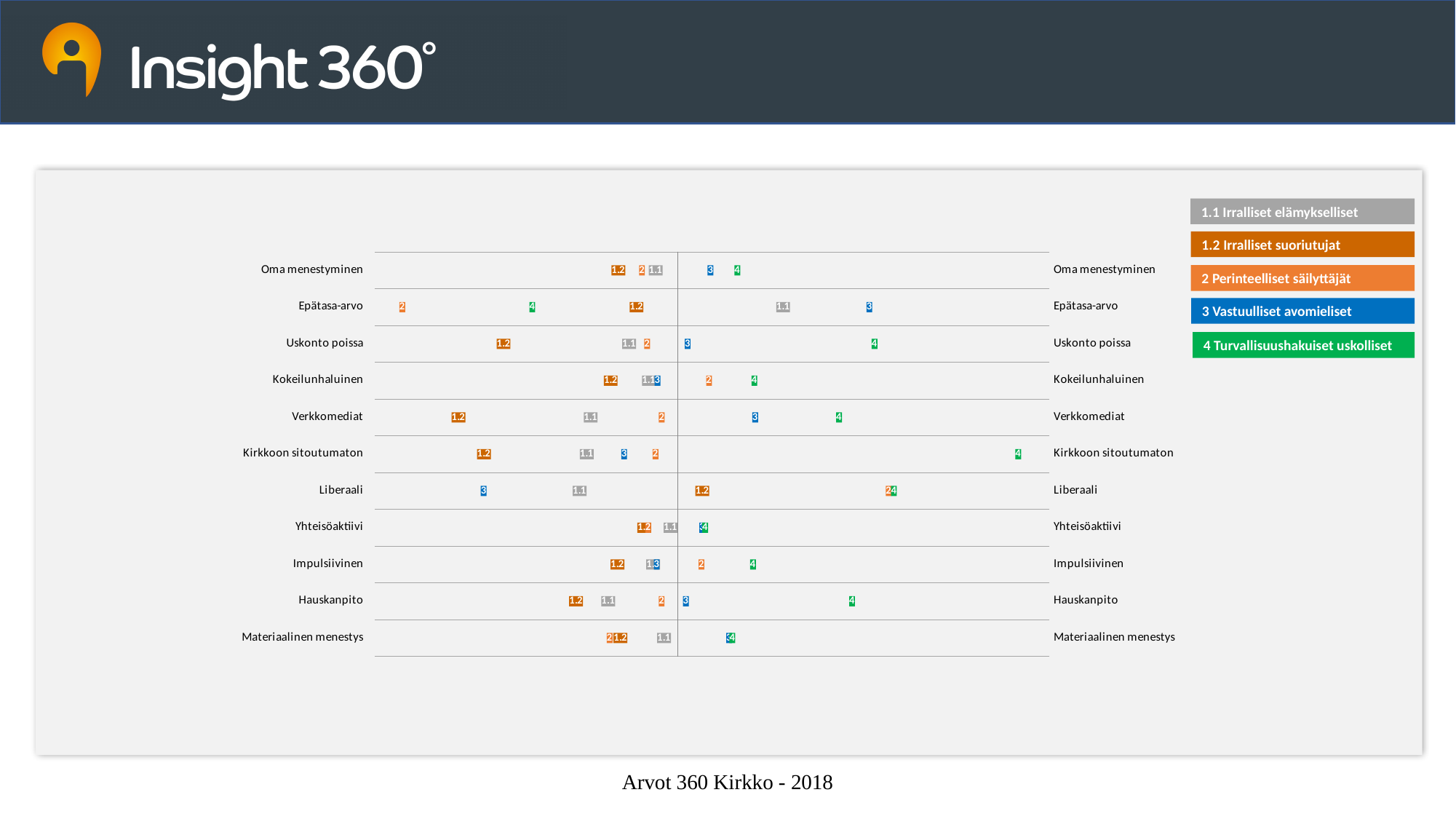
What kind of chart is shown on the slide? Dot plot Which legend entry is shown in green? 4 Turvallisuushakuiset uskolliset How many segments does the legend list? 5 For Uskonto poissa, which is positioned further to the right: segment 1.2 or segment 4? 4 For Epätasa-arvo, which segment is positioned furthest to the right? 3 For Liberaali, is segment 3 positioned to the left or right of the centre line? left What is the title shown beneath the chart? Arvot 360 Kirkko - 2018 How many categories (rows) are plotted on the chart? 11